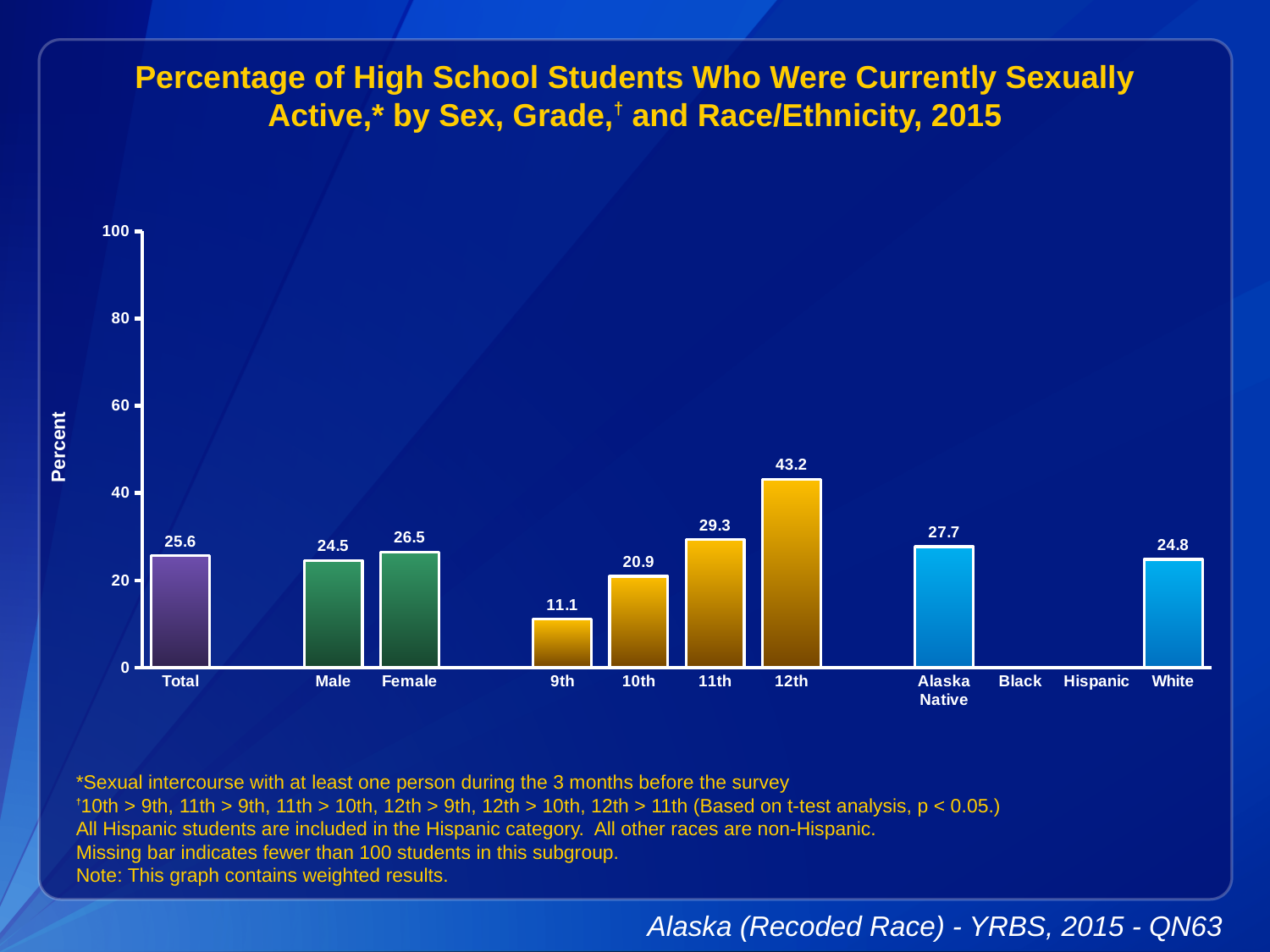
What is the label of the y axis? Percent Which is larger, the value for 11th grade or the value for 10th grade? 11th What is the difference between the Female and Male values? 2.0 What is the value for Total? 25.6 What is the value for Alaska Native? 27.7 Do the values rise or fall from 9th grade to 12th grade? rise What kind of chart is shown? bar chart Is the value for 12th grade greater or less than 40? greater Which category has the lowest value? 9th Which category has the highest value? 12th How many bars are plotted on the chart? 9 What is the value for 12th grade? 43.2